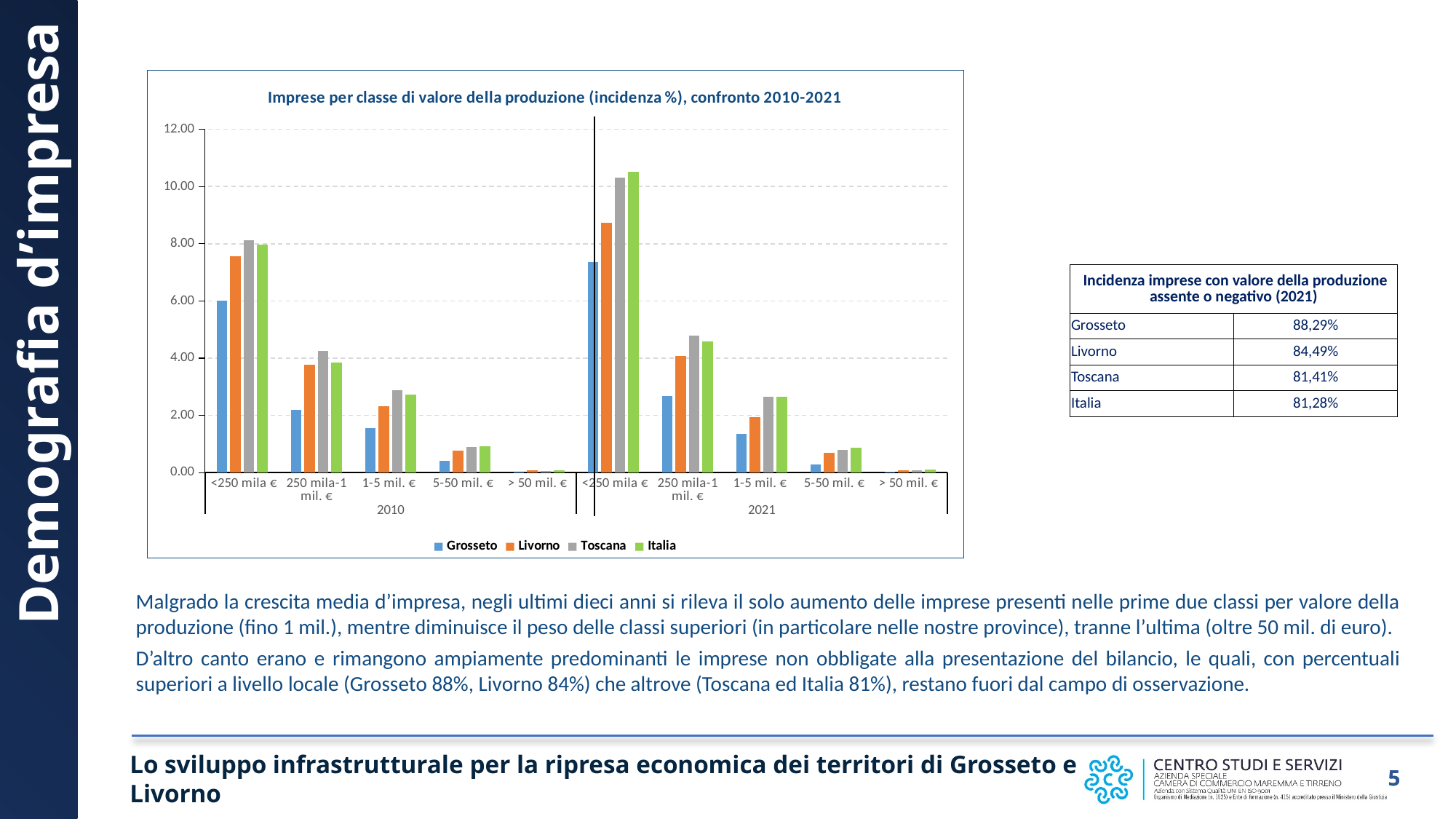
How many series does the legend of the chart list? 4 How many value-of-production classes are shown for each year on the x axis? 5 Is the value for Italia in the '<250 mila €' class for 2021 greater or less than 10.00? greater Which series has the lowest value in the '5-50 mil. €' class for 2021? Grosseto Which series has the lowest value in the '<250 mila €' class for 2010? Grosseto Within the 2021 group, do the values rise or fall as you move from '<250 mila €' to '> 50 mil. €'? fall What is the title of the chart? Imprese per classe di valore della produzione (incidenza %), confronto 2010-2021 For Grosseto in the '<250 mila €' class, is the value larger in 2010 or in 2021? 2021 Is the value for Grosseto in the '<250 mila €' class for 2010 greater or less than 4.00? greater What kind of chart is shown on the slide? bar chart Which series has the highest value in the '250 mila-1 mil. €' class for 2010? Toscana Is the value for Livorno in the '250 mila-1 mil. €' class for 2010 greater or less than 4.00? less